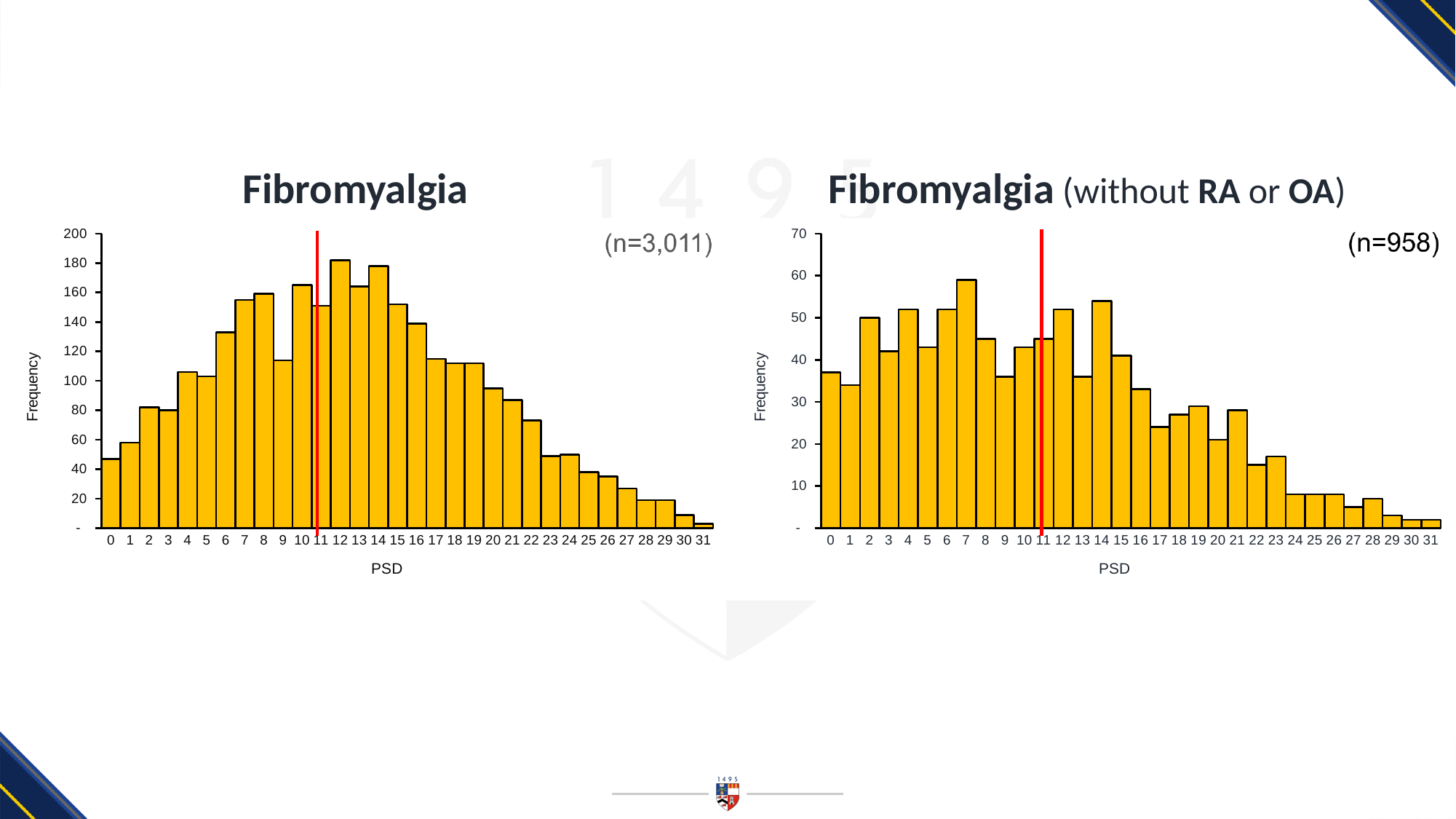
In the left chart (Fibromyalgia, n=3,011), how many PSD categories are shown on the x axis? 32 In the left chart (Fibromyalgia, n=3,011), is the frequency for PSD 12 greater or less than 160? greater In the left chart (Fibromyalgia, n=3,011), is the frequency for PSD 0 greater or less than 60? less In the right chart (Fibromyalgia without RA or OA), which PSD value has the highest frequency? 7 In the right chart (Fibromyalgia without RA or OA), is the frequency for PSD 24 greater or less than 10? less At which PSD value is the red vertical line drawn on both charts? 11 In the left chart (Fibromyalgia, n=3,011), do the frequencies rise or fall from PSD 20 to PSD 31? fall In the left chart (Fibromyalgia, n=3,011), which PSD value has the lowest frequency? 31 What is the sample size shown for the right chart (Fibromyalgia without RA or OA)? n=958 What kind of chart is the left chart titled 'Fibromyalgia'? bar chart In the right chart (Fibromyalgia without RA or OA), which is larger, the frequency for PSD 7 or the frequency for PSD 9? PSD 7